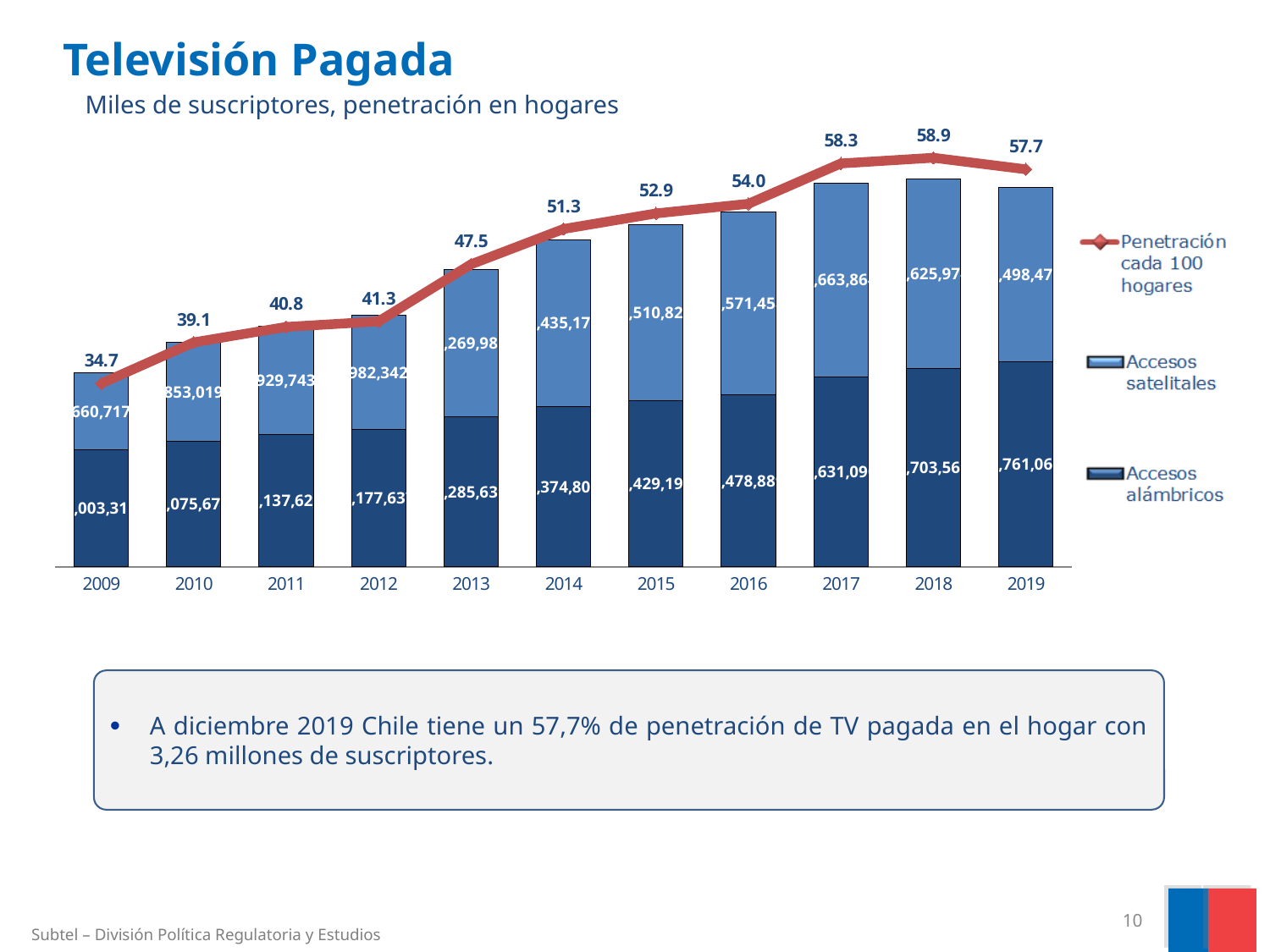
What is the value of Penetración cada 100 hogares for 2019? 57.7 How many series does the legend list? 3 What is the difference between the Penetración cada 100 hogares values for 2018 and 2019? 1.2 How many years are shown on the x axis of the chart? 11 What is the value of Accesos satelitales for 2009? 660,717 Which year has a higher Penetración cada 100 hogares, 2013 or 2014? 2014 In which year is Penetración cada 100 hogares lowest? 2009 What kind of chart is shown on the slide? A combination of a stacked bar chart and a line chart What is the difference between the Accesos satelitales values for 2012 and 2009? 321,625 Does Penetración cada 100 hogares rise or fall from 2009 to 2018? It rises In which year is Penetración cada 100 hogares highest? 2018 What is the value of Penetración cada 100 hogares for 2009? 34.7